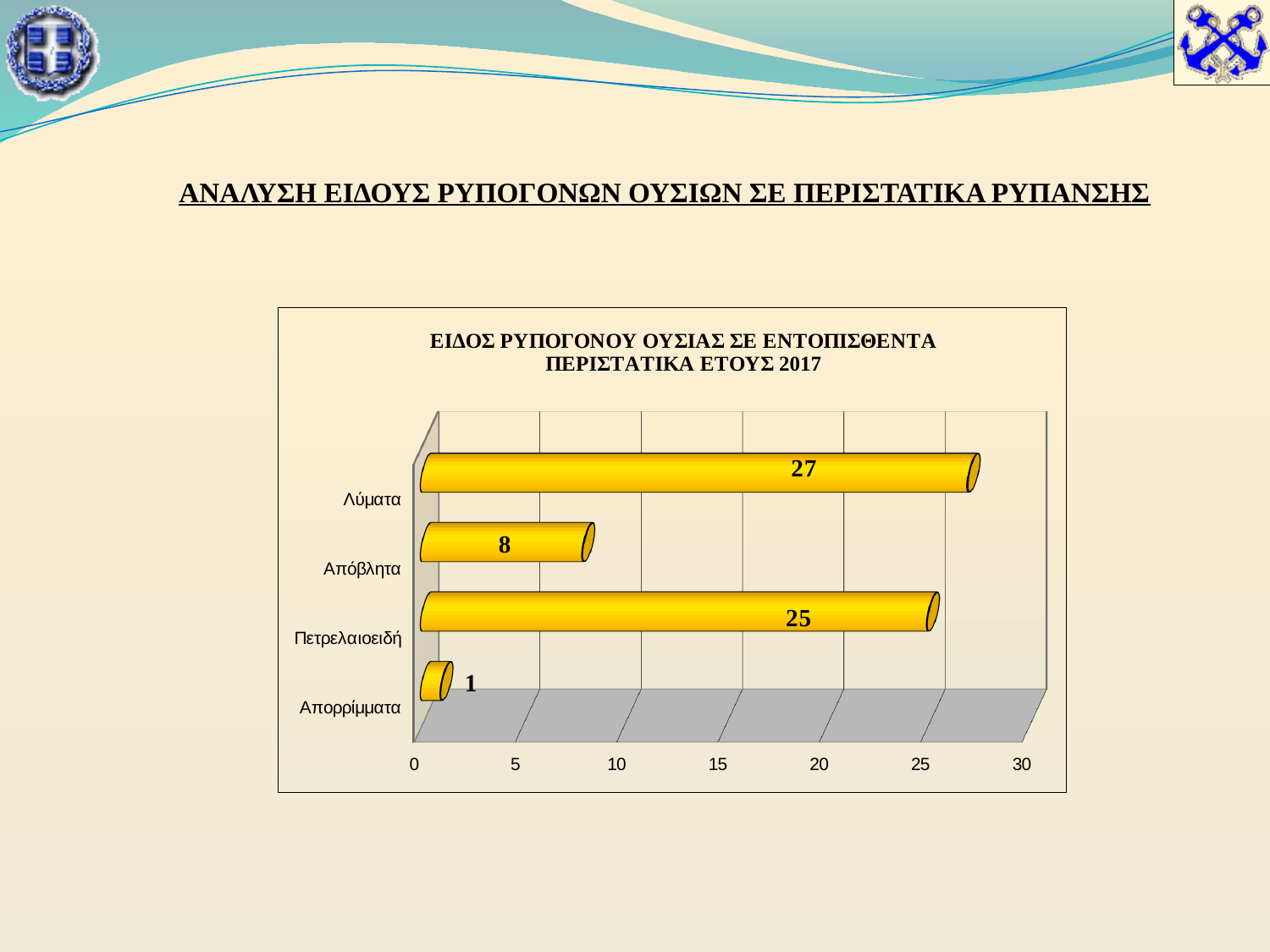
Which category has the lowest value? Απορρίμματα What is the difference between the values for Λύματα and Πετρελαιοειδή? 2 Which is larger, the value for Απόβλητα or the value for Πετρελαιοειδή? Πετρελαιοειδή Which category has the highest value? Λύματα What is the value for Απορρίμματα? 1 What is the value for Λύματα? 27 What is the difference between the values for Απόβλητα and Απορρίμματα? 7 What is the title of the chart? ΕΙΔΟΣ ΡΥΠΟΓΟΝΟΥ ΟΥΣΙΑΣ ΣΕ ΕΝΤΟΠΙΣΘΕΝΤΑ ΠΕΡΙΣΤΑΤΙΚΑ ΕΤΟΥΣ 2017 What is the value for Πετρελαιοειδή? 25 How many categories are shown in the chart? 4 What kind of chart is shown on the slide? Bar chart What is the value for Απόβλητα? 8